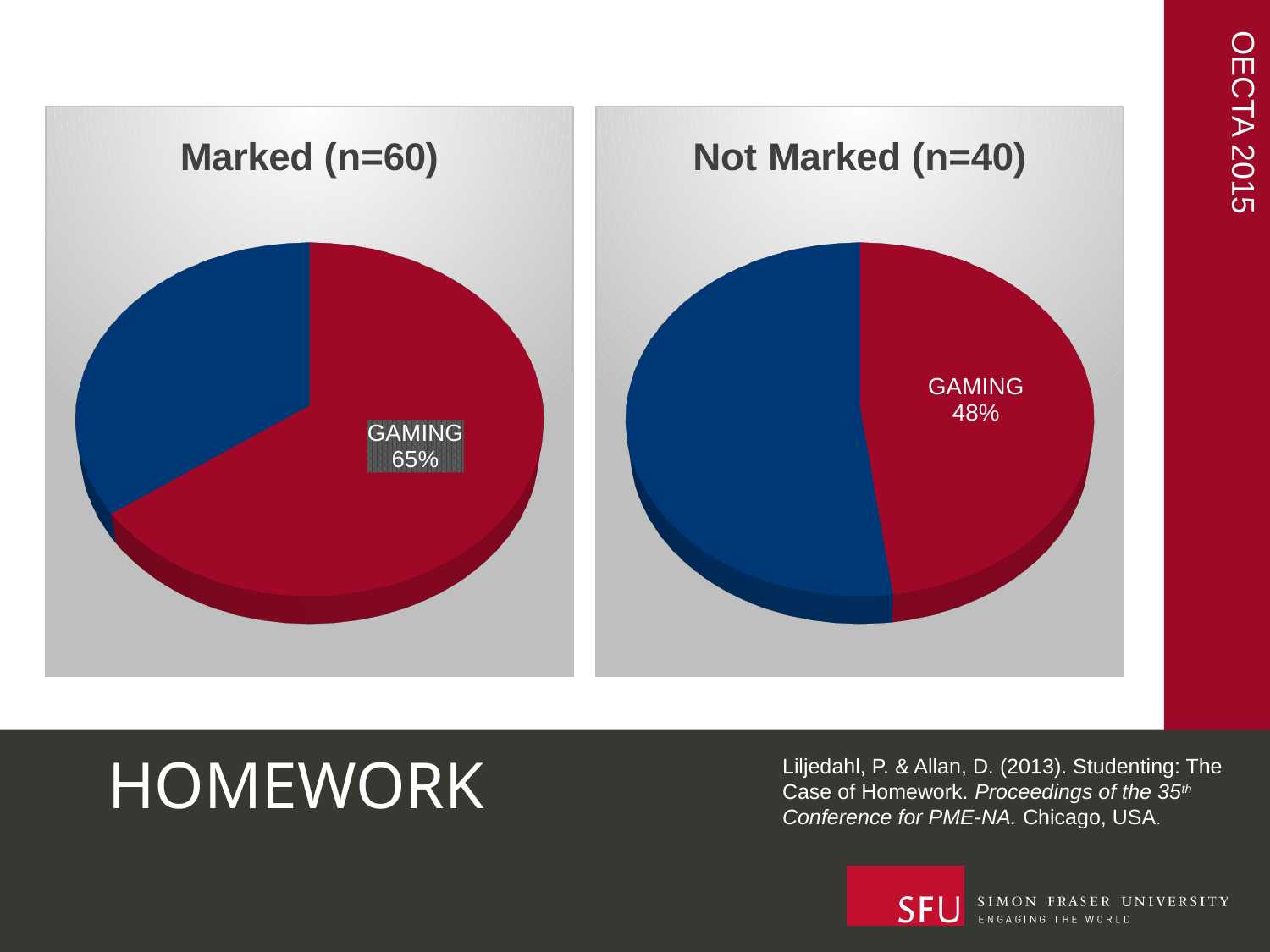
In the Not Marked (n=40) pie chart, what percentage is labelled for GAMING? 48% What type of chart is used for Marked (n=60)? Pie chart In the Marked (n=60) pie chart, what percentage is labelled for GAMING? 65% Which chart shows a larger share for GAMING, Marked (n=60) or Not Marked (n=40)? Marked (n=60) What is the difference in percentage points between the GAMING share in the Marked (n=60) chart and the GAMING share in the Not Marked (n=40) chart? 17 percentage points In the Not Marked (n=40) pie chart, is the GAMING slice larger or smaller than the other slice? Smaller How many slices does the Marked (n=60) pie chart have? 2 In both pie charts, what colour is the GAMING slice? Red How many slices does the Not Marked (n=40) pie chart have? 2 In the Marked (n=60) pie chart, is the GAMING slice larger or smaller than the other slice? Larger What is the title of the pie chart on the left of the slide? Marked (n=60) What type of chart is used for Not Marked (n=40)? Pie chart